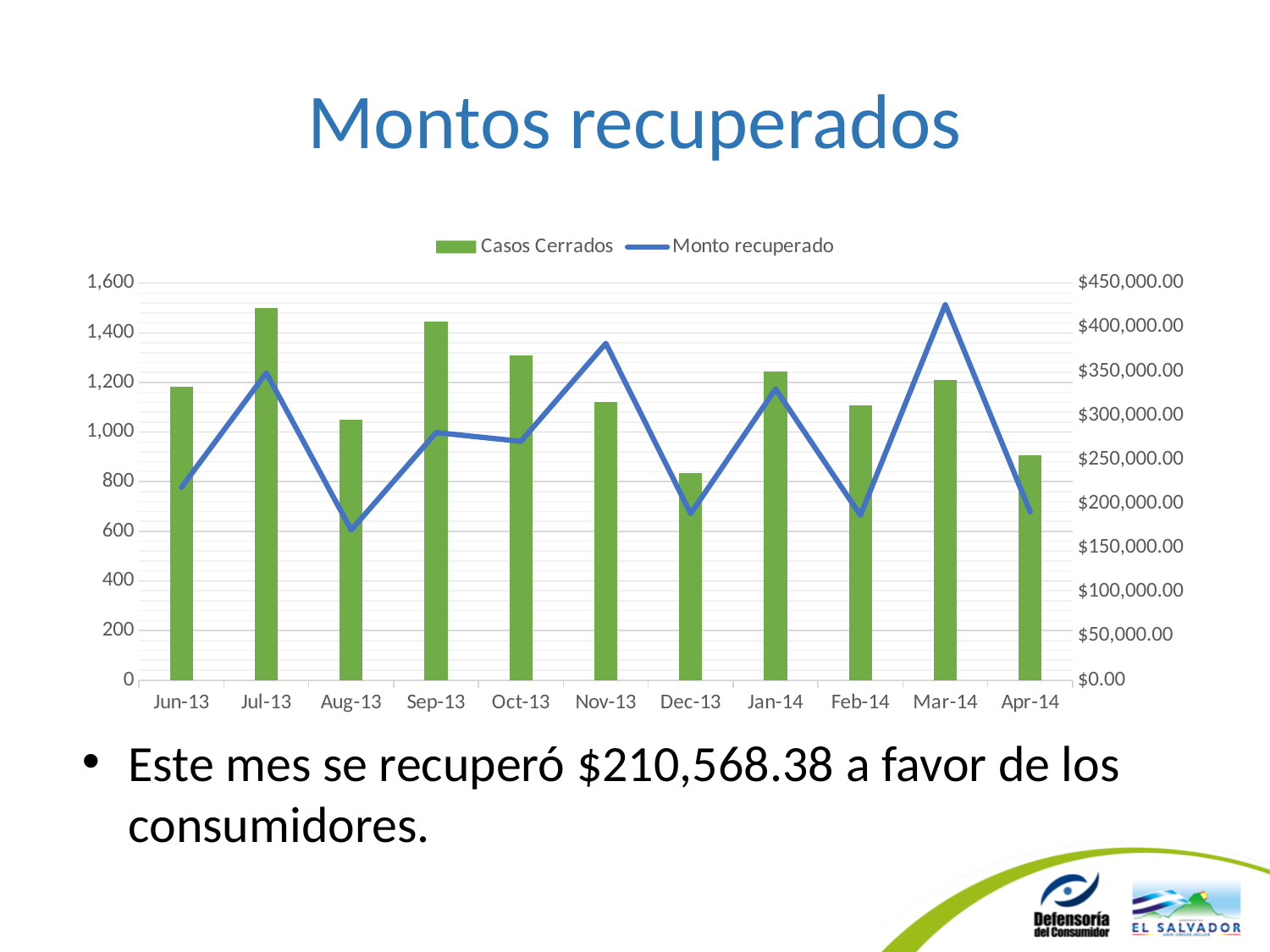
Is the Monto recuperado for Aug-13 greater or less than $200,000.00? less Is the number of Casos Cerrados for Jul-13 greater or less than 1,400? greater How many months are shown on the x axis of the chart? 11 What kind of chart is shown on the slide? A combined bar and line chart Which month has the highest number of Casos Cerrados? Jul-13 How many series does the legend list? 2 Is the number of Casos Cerrados for Dec-13 greater or less than 1,000? less Do the Casos Cerrados bars rise or fall from Sep-13 to Dec-13? fall Which month has the lowest number of Casos Cerrados? Dec-13 Which month has more Casos Cerrados, Sep-13 or Oct-13? Sep-13 Which month has the highest Monto recuperado? Mar-14